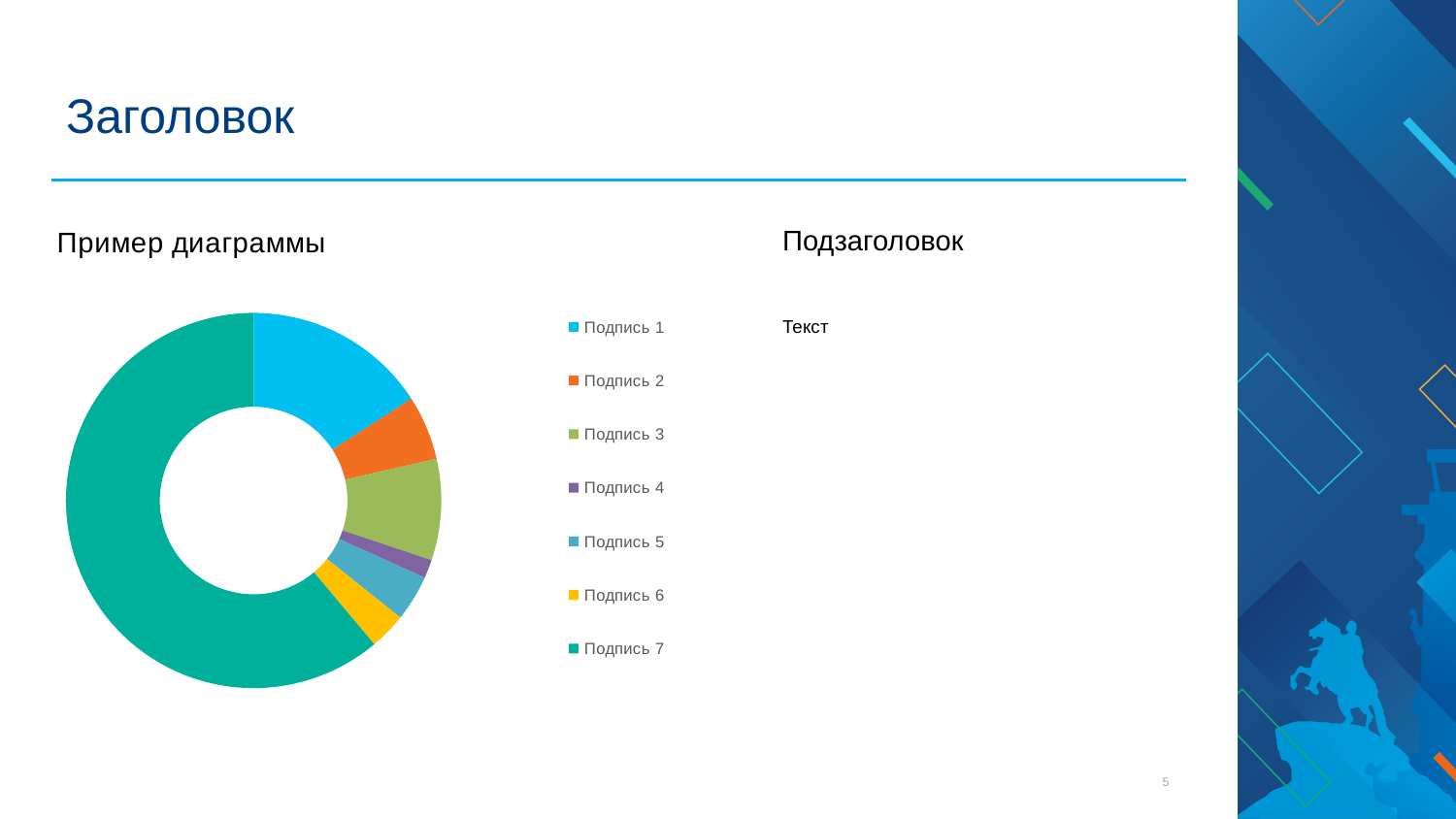
Which is larger, the slice for Подпись 7 or the slice for Подпись 1? Подпись 7 Which category has the largest slice in the chart? Подпись 7 Does the slice for Подпись 1 take up more or less than half of the chart? less Does the slice for Подпись 7 take up more or less than half of the chart? more What is the first entry listed in the chart's legend? Подпись 1 What is the title shown above the chart? Пример диаграммы How many categories does the chart's legend list? 7 Which is larger, the slice for Подпись 1 or the slice for Подпись 2? Подпись 1 Which is larger, the slice for Подпись 3 or the slice for Подпись 2? Подпись 3 What kind of chart is shown on the slide? Donut (pie) chart